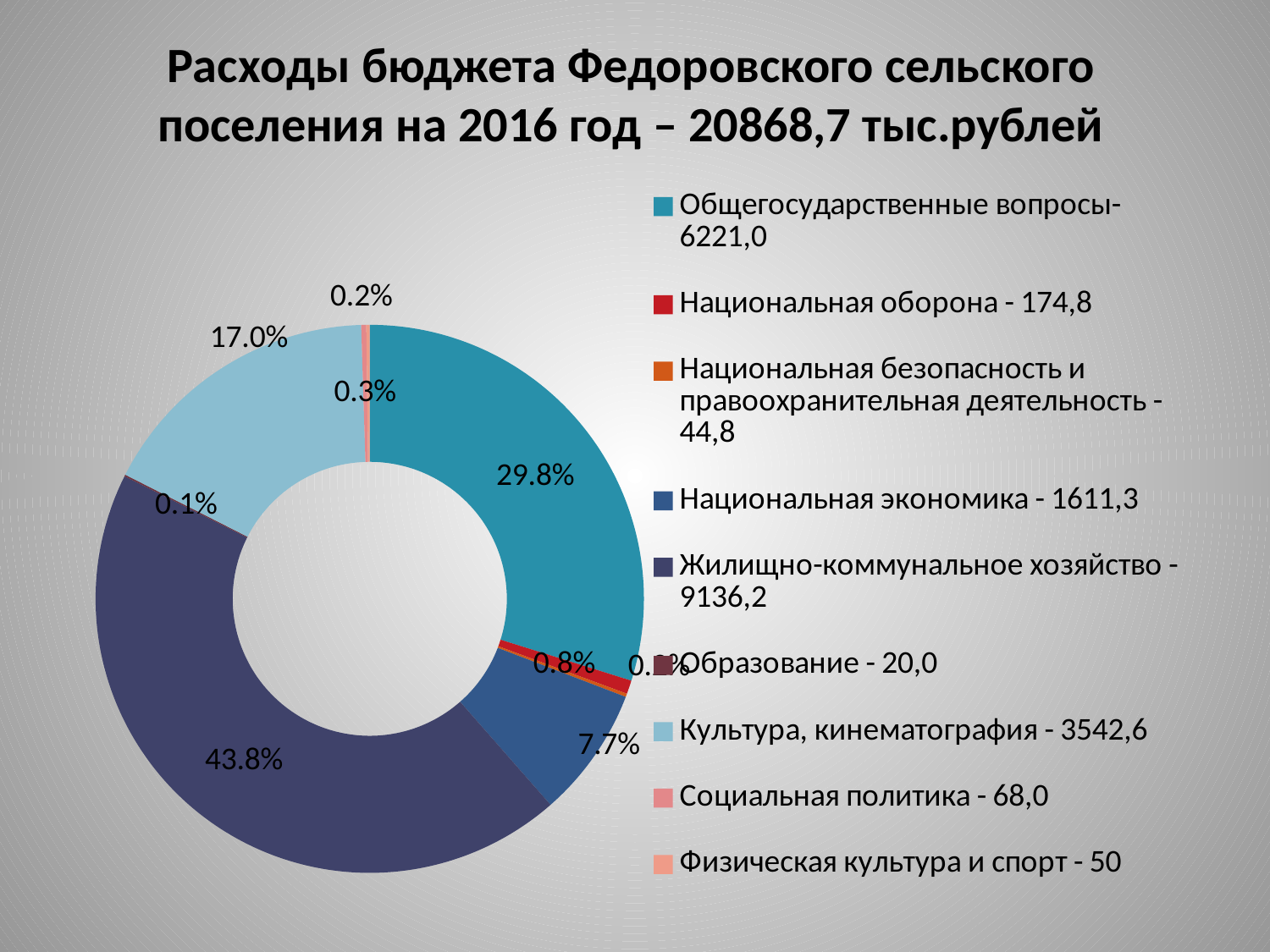
What share of the budget goes to Жилищно-коммунальное хозяйство? 43.8% What total budget amount is stated in the chart title? 20868,7 тыс.рублей What share of the budget goes to Общегосударственные вопросы? 29.8% How many categories does the legend list? 9 According to the legend, what amount (in тыс. рублей) is allocated to Национальная оборона? 174,8 What share of the budget goes to Культура, кинематография? 17.0% Which category has the smallest share of the budget? Образование What is the difference in percentage points between the shares of Жилищно-коммунальное хозяйство and Общегосударственные вопросы? 14.0 percentage points What kind of chart is shown on the slide? Doughnut (pie) chart Which category has the largest share of the budget? Жилищно-коммунальное хозяйство Which is larger: the share for Культура, кинематография or the share for Национальная экономика? Культура, кинематография